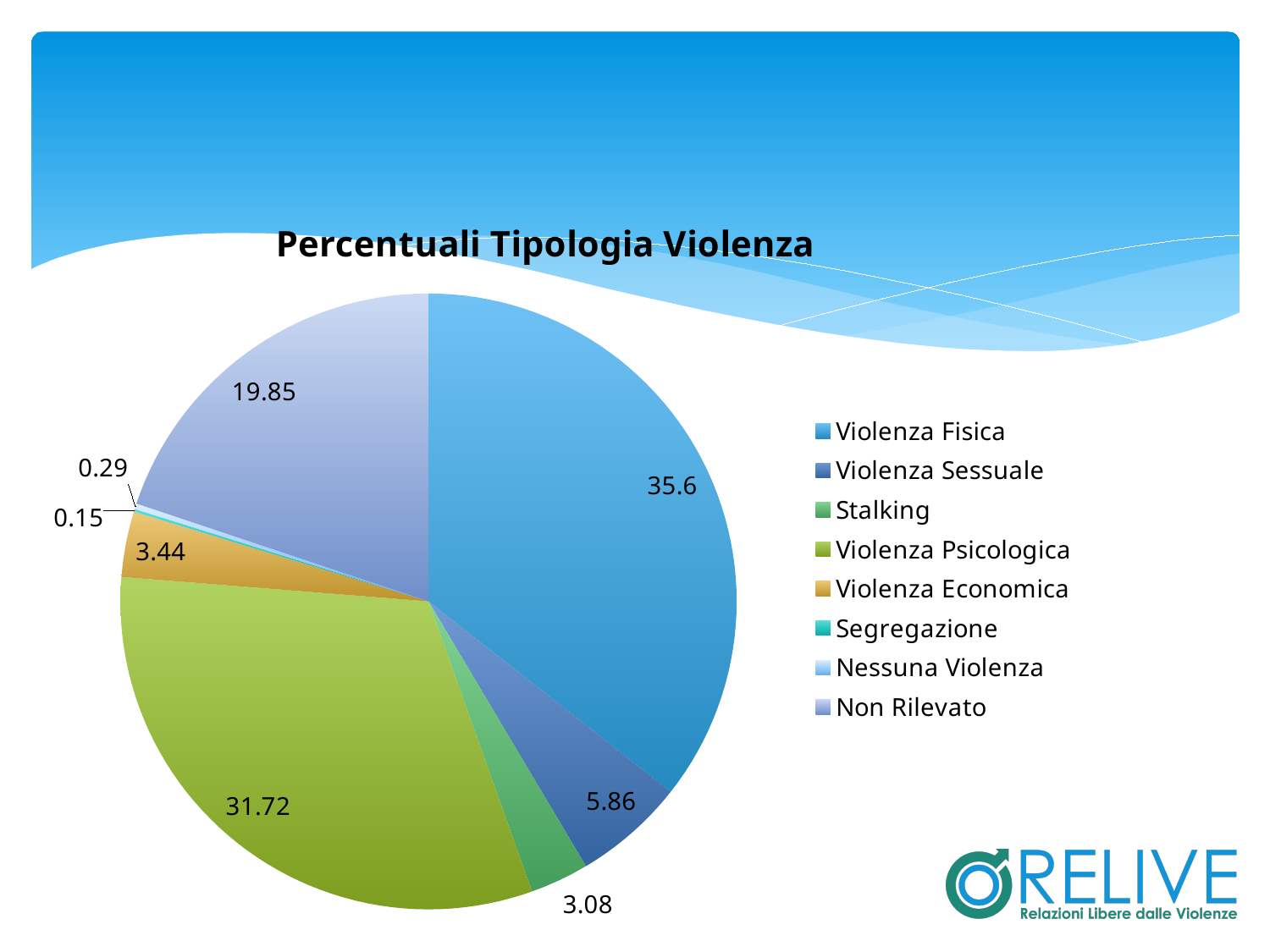
What is the difference between the values for Violenza Fisica and Violenza Psicologica? 3.88 What is the value shown for Violenza Psicologica? 31.72 What is the title of the chart? Percentuali Tipologia Violenza What type of chart is shown on the slide? pie chart What is the value shown for Violenza Economica? 3.44 What is the value shown for Stalking? 3.08 How many categories does the legend list? 8 What is the value shown for Violenza Sessuale? 5.86 What is the value shown for Non Rilevato? 19.85 What is the smallest value labelled on the pie? 0.15 Which category has the largest slice of the pie? Violenza Fisica What is the value shown for Violenza Fisica? 35.6